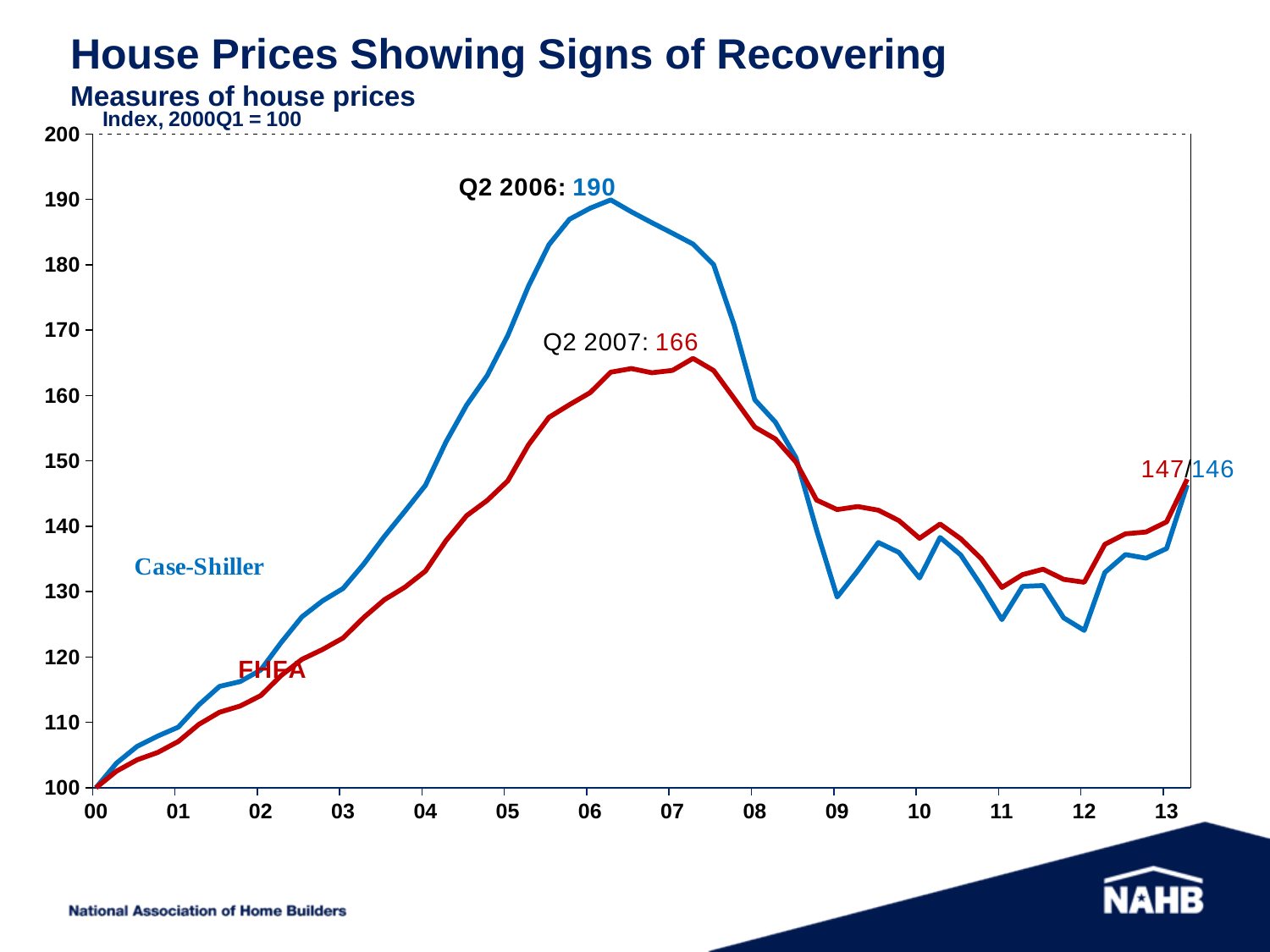
What kind of chart is shown on the slide? line chart What was the Case-Shiller index value at its peak in Q2 2006? 190 What is the latest FHFA index value shown at the right end of the chart? 147 What is the difference between the Case-Shiller peak (Q2 2006) and the FHFA peak (Q2 2007)? 24 What was the FHFA index value at its peak in Q2 2007? 166 Which series reached the higher peak value, Case-Shiller or FHFA? Case-Shiller Is the Case-Shiller value at the start of 2012 greater or less than 130? less What colour is the Case-Shiller line on the chart? blue What is the latest Case-Shiller index value shown at the right end of the chart? 146 Does the Case-Shiller index rise or fall between 2000 and 2006? rise Is the FHFA value at the start of 2011 greater or less than 140? less How many series are plotted on the chart? 2